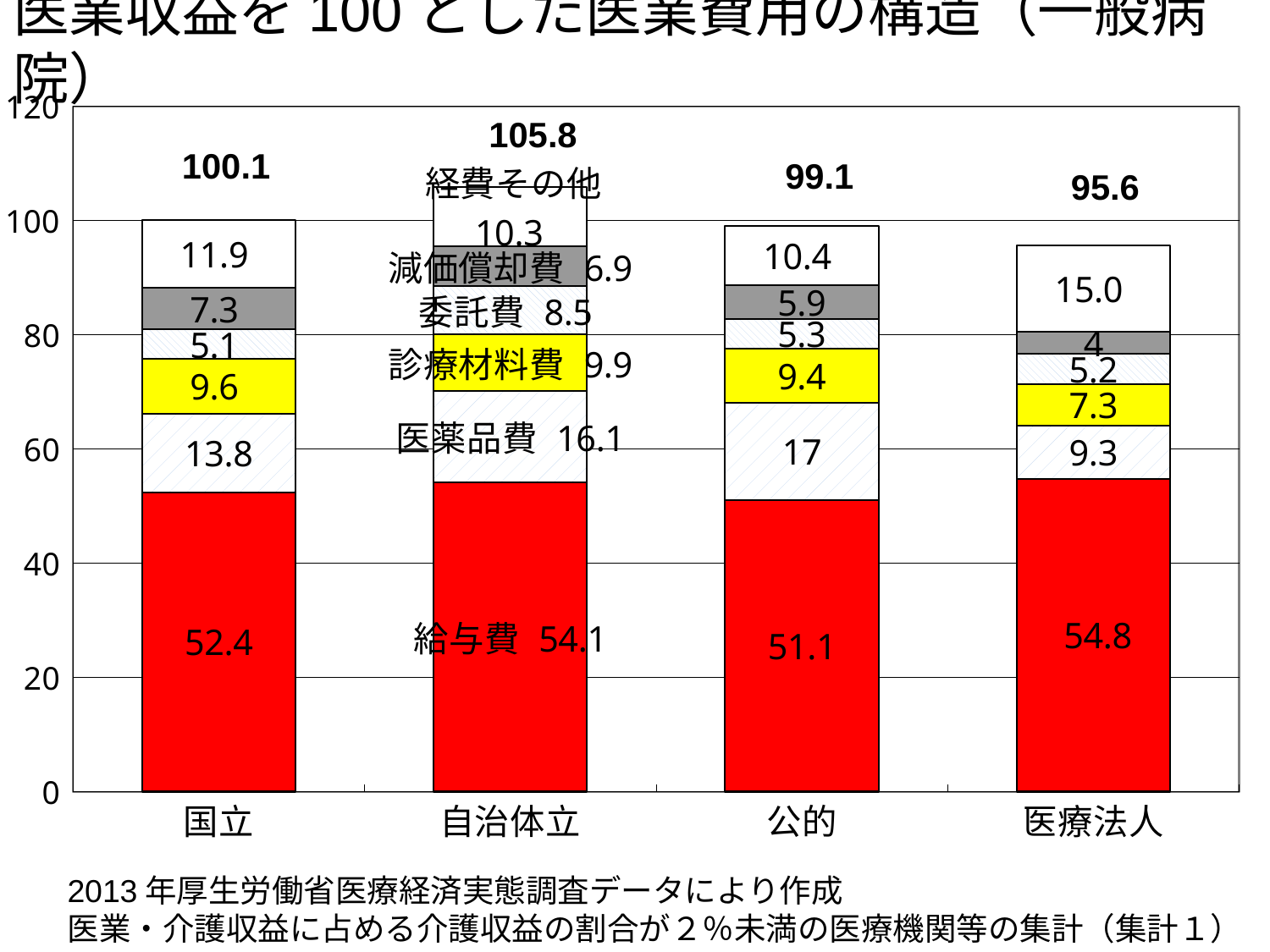
What is the difference between the 給与費 values for 医療法人 and 公的? 3.7 What is the value of 経費その他 for 医療法人? 15.0 What colour is used for the 給与費 segment? red Is the total for 公的 greater or less than 100? less How many hospital categories are shown on the x axis? 4 Which category has the highest total? 自治体立 What is the total shown above the 自治体立 bar? 105.8 What type of chart is shown on the slide? stacked bar chart What is the value of 給与費 for 国立? 52.4 Which is larger, the 減価償却費 value for 国立 or for 医療法人? 国立 What is the value of 医薬品費 for 公的? 17 Which category has the lowest total? 医療法人